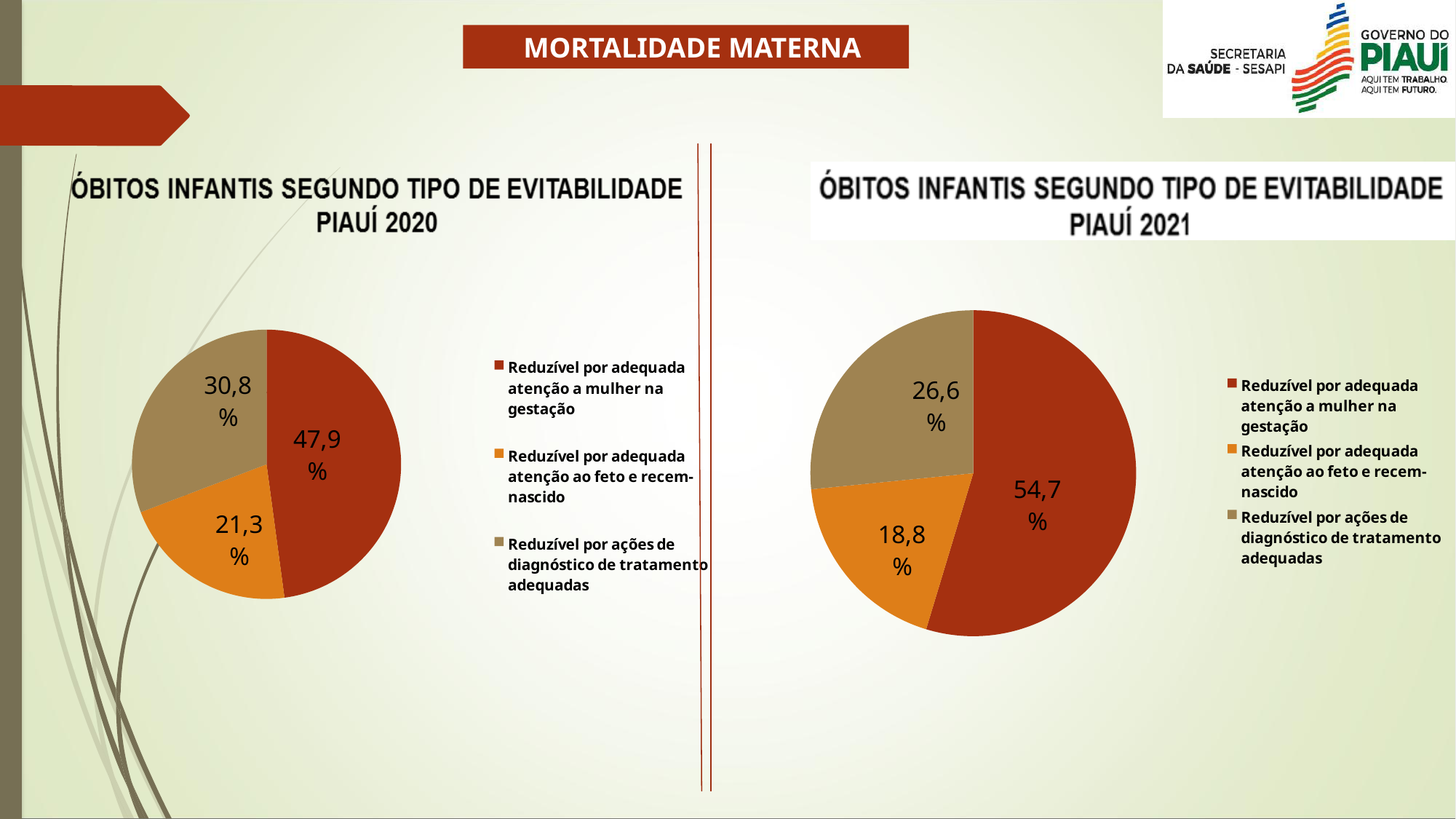
How many categories does the 'ÓBITOS INFANTIS SEGUNDO TIPO DE EVITABILIDADE PIAUÍ 2021' chart show? 3 In the 'ÓBITOS INFANTIS SEGUNDO TIPO DE EVITABILIDADE PIAUÍ 2020' chart, what share is labelled for 'Reduzível por adequada atenção a mulher na gestação'? 47,9% In the 'ÓBITOS INFANTIS SEGUNDO TIPO DE EVITABILIDADE PIAUÍ 2020' chart, which category has the largest slice? Reduzível por adequada atenção a mulher na gestação In the 'ÓBITOS INFANTIS SEGUNDO TIPO DE EVITABILIDADE PIAUÍ 2021' chart, what is the difference between the shares for 'Reduzível por adequada atenção a mulher na gestação' and 'Reduzível por adequada atenção ao feto e recem-nascido'? 35,9% In the 'ÓBITOS INFANTIS SEGUNDO TIPO DE EVITABILIDADE PIAUÍ 2021' chart, what colour is the slice for 'Reduzível por adequada atenção a mulher na gestação'? Dark red In the 'ÓBITOS INFANTIS SEGUNDO TIPO DE EVITABILIDADE PIAUÍ 2020' chart, what share is labelled for 'Reduzível por adequada atenção ao feto e recem-nascido'? 21,3% What kind of chart is the 'ÓBITOS INFANTIS SEGUNDO TIPO DE EVITABILIDADE PIAUÍ 2020' chart? Pie chart In the 'ÓBITOS INFANTIS SEGUNDO TIPO DE EVITABILIDADE PIAUÍ 2021' chart, what share is labelled for 'Reduzível por adequada atenção ao feto e recem-nascido'? 18,8% In the 'ÓBITOS INFANTIS SEGUNDO TIPO DE EVITABILIDADE PIAUÍ 2020' chart, what is the difference between the shares for 'Reduzível por adequada atenção a mulher na gestação' and 'Reduzível por ações de diagnóstico de tratamento adequadas'? 17,1% In the 'ÓBITOS INFANTIS SEGUNDO TIPO DE EVITABILIDADE PIAUÍ 2021' chart, which category has the smallest slice? Reduzível por adequada atenção ao feto e recem-nascido In the 'ÓBITOS INFANTIS SEGUNDO TIPO DE EVITABILIDADE PIAUÍ 2020' chart, which is larger: the share for 'Reduzível por adequada atenção ao feto e recem-nascido' or for 'Reduzível por ações de diagnóstico de tratamento adequadas'? Reduzível por ações de diagnóstico de tratamento adequadas In the 'ÓBITOS INFANTIS SEGUNDO TIPO DE EVITABILIDADE PIAUÍ 2021' chart, what share is labelled for 'Reduzível por ações de diagnóstico de tratamento adequadas'? 26,6%